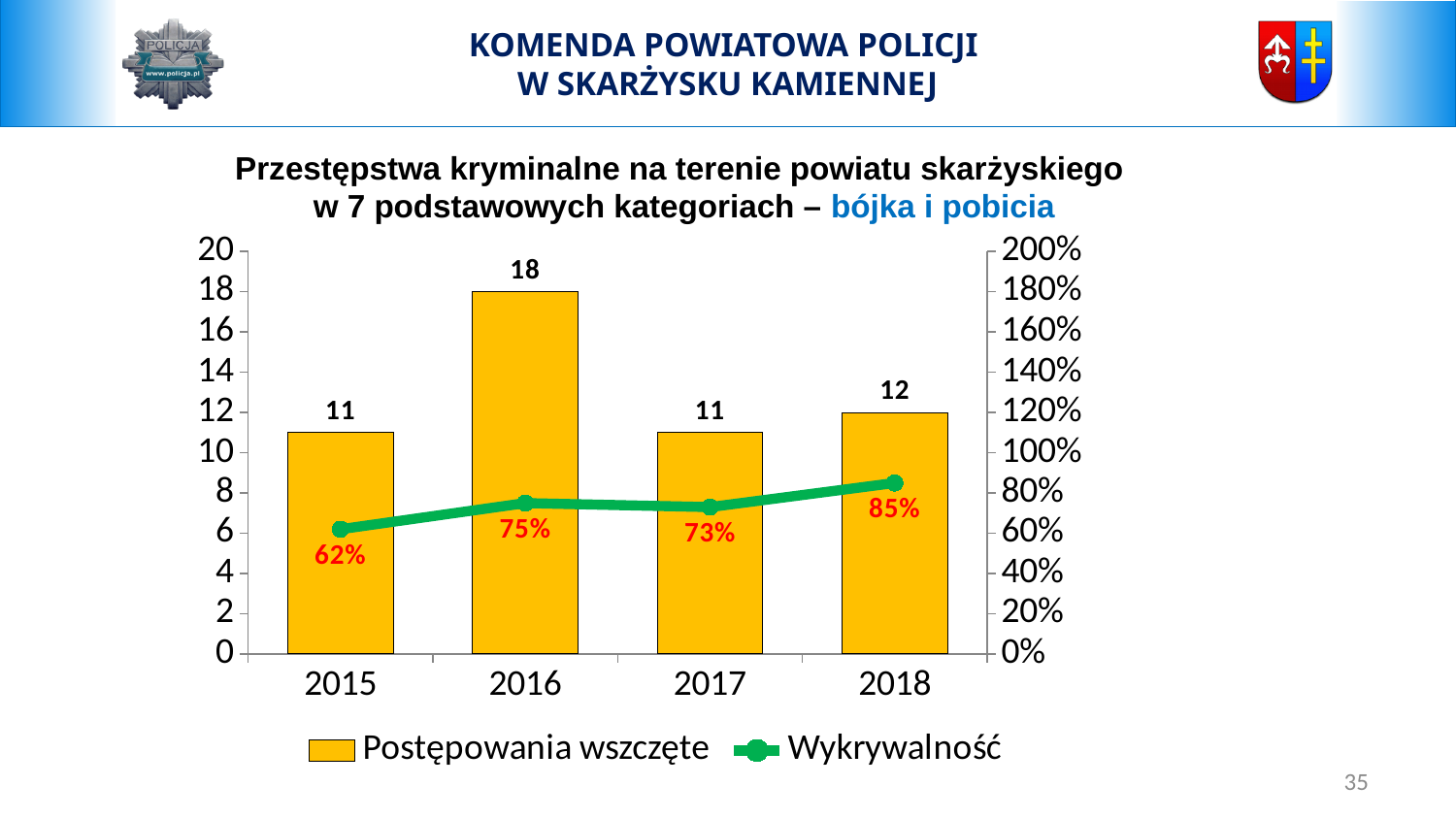
What is the value of Postępowania wszczęte for 2016? 18 How many years are shown on the x axis? 4 Which year has the highest value of Postępowania wszczęte? 2016 What is the Wykrywalność value for 2018? 85% What colour are the bars for Postępowania wszczęte? Yellow How many series does the legend list? 2 Which year has the lowest Wykrywalność? 2015 Does Wykrywalność rise or fall from 2017 to 2018? Rise What is the Wykrywalność value for 2015? 62% What is the difference between Postępowania wszczęte in 2016 and 2018? 6 Which is larger: Wykrywalność in 2016 or in 2017? 2016 What kind of chart is shown on the slide? Combined bar and line chart